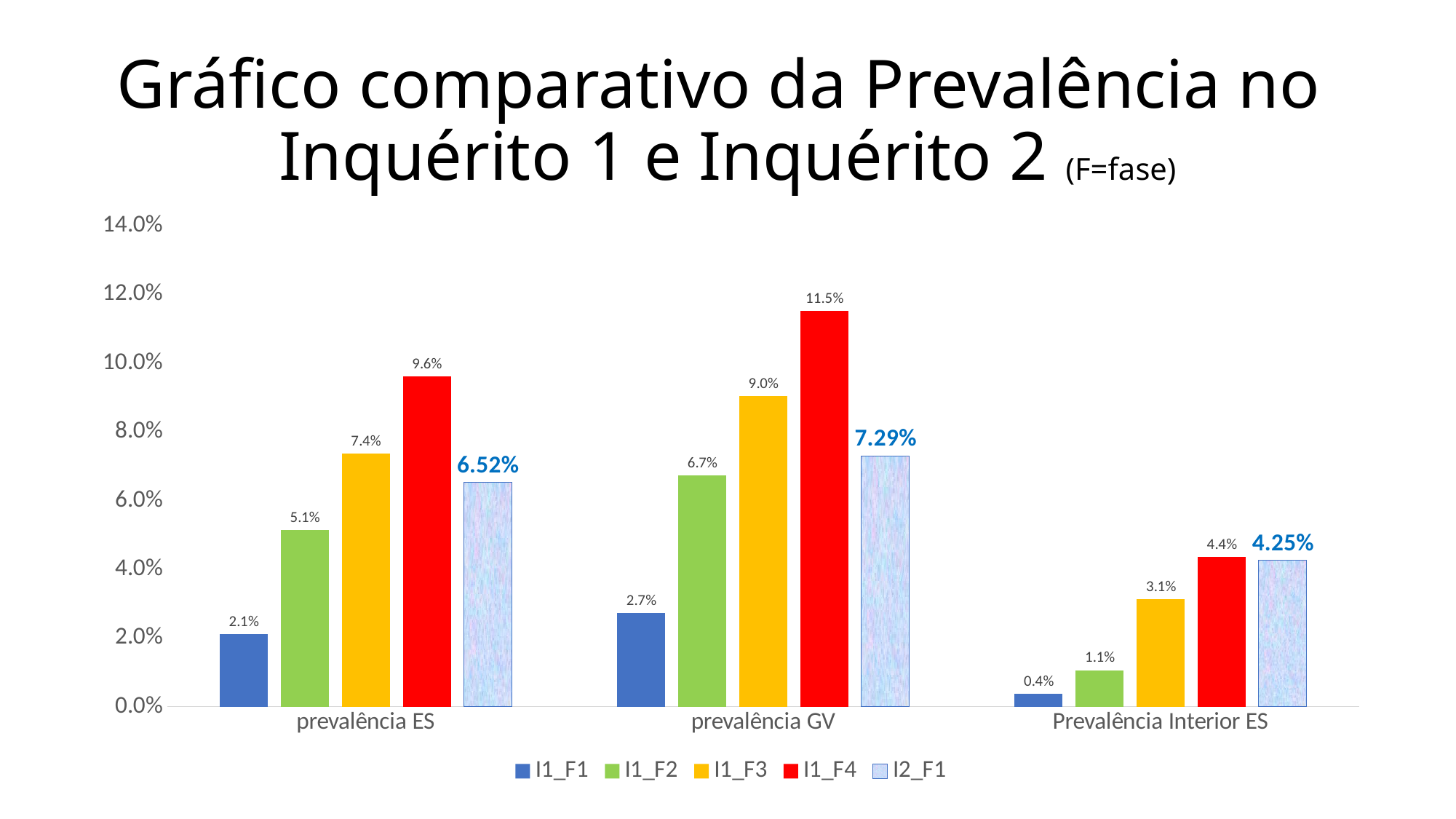
What is the value of I1_F4 for prevalência GV? 11.5% How many series does the legend list? 5 Which series has the highest value for prevalência ES? I1_F4 What is the value of I1_F3 for prevalência GV? 9.0% What is the value of I1_F1 for Prevalência Interior ES? 0.4% What colour are the I1_F4 bars? red How many categories are shown on the x axis? 3 What kind of chart is shown on the slide? bar chart Which is larger: I1_F3 for prevalência ES or I1_F3 for prevalência GV? prevalência GV What is the difference between the I1_F4 and I1_F1 values for prevalência GV? 8.8% Which category has the lowest I1_F2 value? Prevalência Interior ES What is the value of I2_F1 for prevalência ES? 6.52%